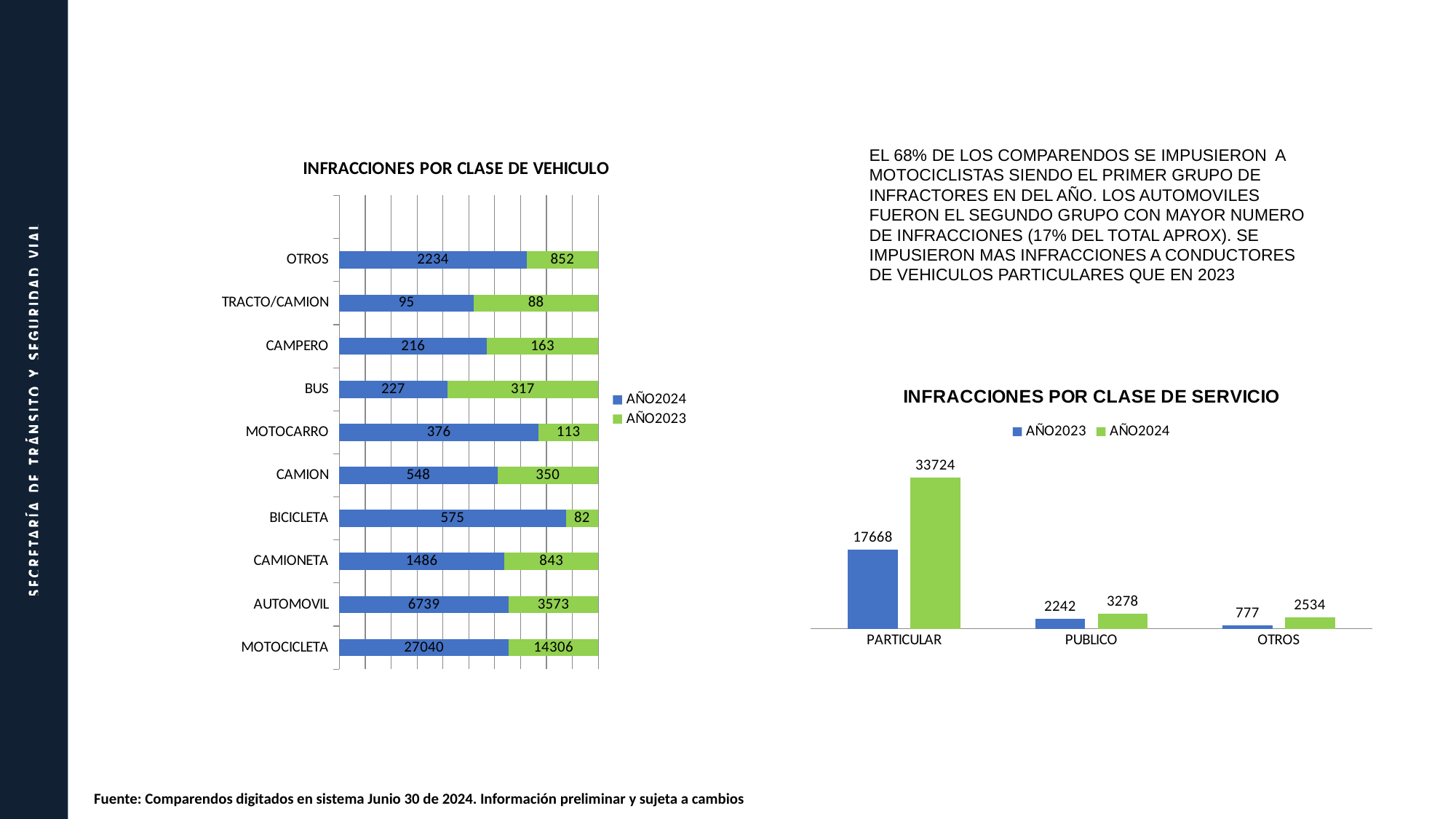
In the chart 'INFRACCIONES POR CLASE DE VEHICULO', which is larger for BUS: the AÑO2024 value or the AÑO2023 value? AÑO2023 In the chart 'INFRACCIONES POR CLASE DE VEHICULO', what is the total of the stacked bar for OTROS? 3086 In the chart 'INFRACCIONES POR CLASE DE VEHICULO', which category has the highest AÑO2024 value? MOTOCICLETA In the chart 'INFRACCIONES POR CLASE DE VEHICULO', what is the AÑO2023 value for AUTOMOVIL? 3573 In the chart 'INFRACCIONES POR CLASE DE VEHICULO', what is the difference between the AÑO2024 and AÑO2023 values for CAMIONETA? 643 In the chart 'INFRACCIONES POR CLASE DE SERVICIO', how many series does the legend list? 2 In the chart 'INFRACCIONES POR CLASE DE VEHICULO', which category has the lowest AÑO2023 value? BICICLETA In the chart 'INFRACCIONES POR CLASE DE SERVICIO', what is the difference between the AÑO2024 and AÑO2023 values for OTROS? 1757 In the chart 'INFRACCIONES POR CLASE DE VEHICULO', what is the AÑO2024 value for MOTOCICLETA? 27040 In the chart 'INFRACCIONES POR CLASE DE VEHICULO', how many vehicle categories are shown? 10 In the chart 'INFRACCIONES POR CLASE DE SERVICIO', what is the AÑO2024 value for PARTICULAR? 33724 What kind of chart is 'INFRACCIONES POR CLASE DE SERVICIO'? Bar chart